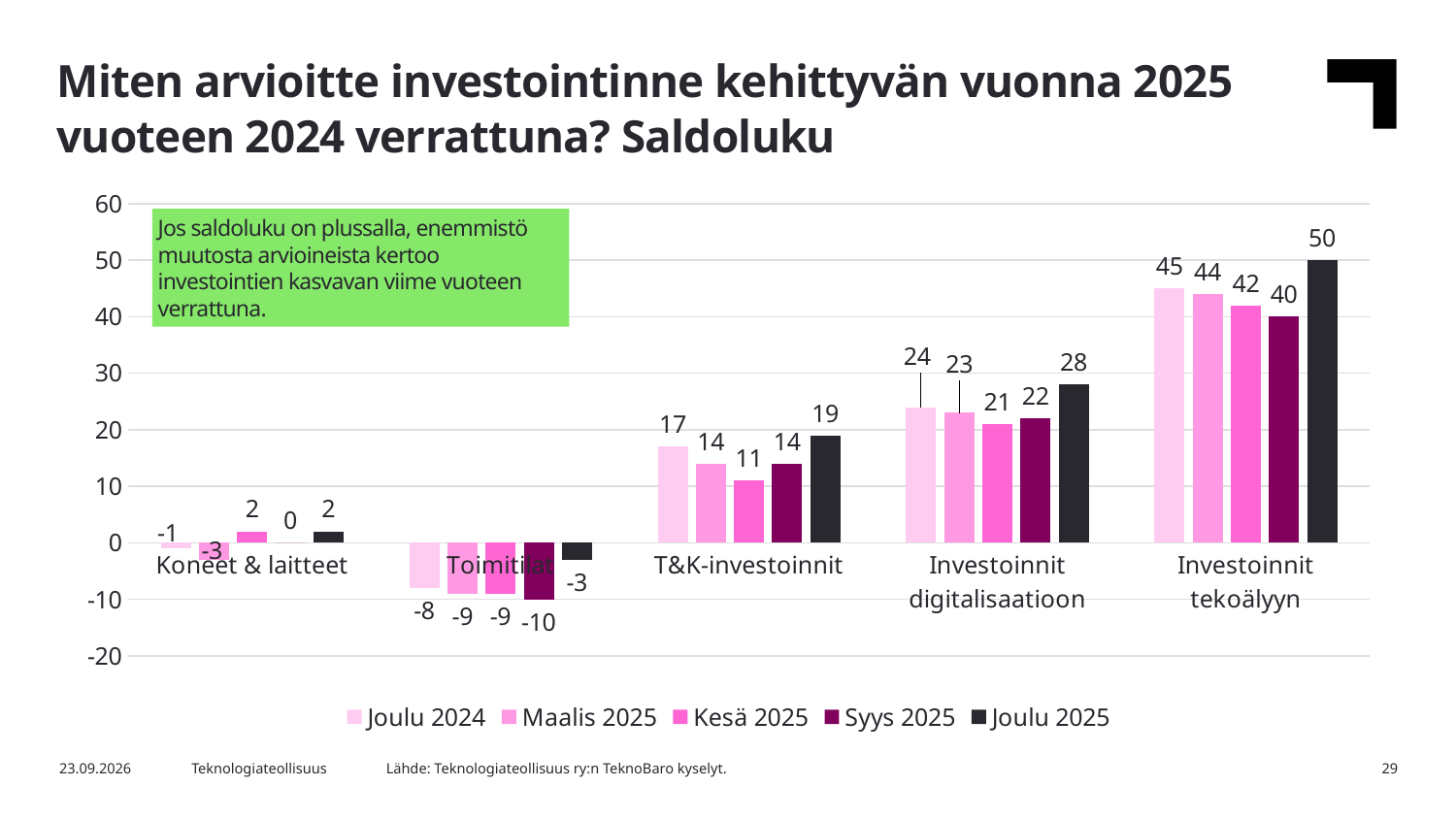
What kind of chart is shown on the slide? Bar chart Which category has the highest value in the Joulu 2025 series? Investoinnit tekoälyyn What is the value for Investoinnit digitalisaatioon in the Joulu 2024 series? 24 What is the value for Toimitilat in the Syys 2025 series? -10 Which is larger for T&K-investoinnit: the Joulu 2024 value or the Joulu 2025 value? Joulu 2025 What is the value for T&K-investoinnit in the Kesä 2025 series? 11 What is the difference between the Joulu 2025 and Joulu 2024 values for Investoinnit tekoälyyn? 5 What is the value for Investoinnit tekoälyyn in the Joulu 2025 series? 50 How many categories are shown on the x axis? 5 Which category has the lowest value in the Maalis 2025 series? Toimitilat What is the last series listed in the legend? Joulu 2025 How many series does the legend list? 5